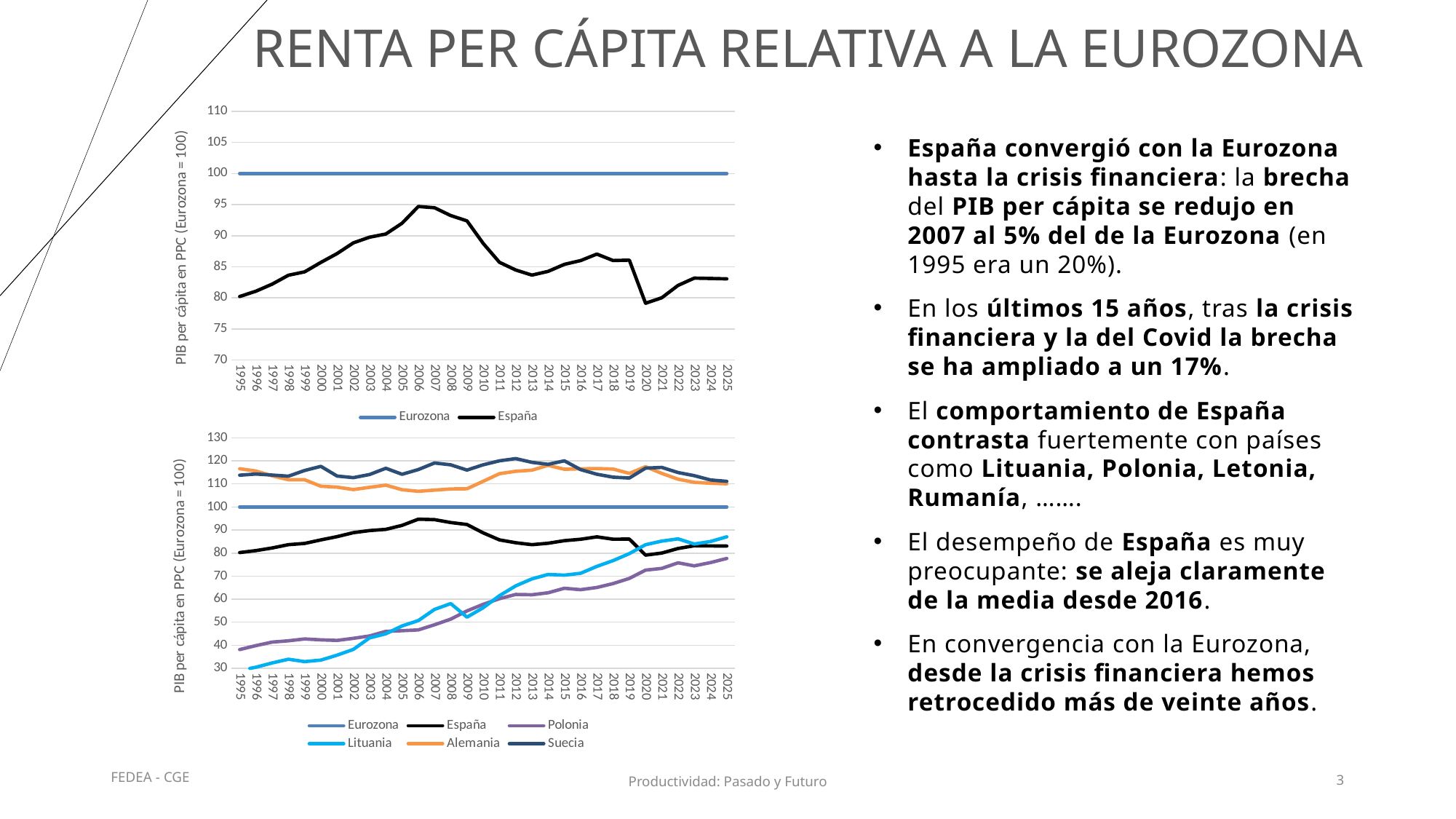
In the top chart, is the value for España in 2020 greater or less than 80? less In the bottom chart, which series has the lowest value in 1995? Lituania How many series does the legend of the bottom chart list? 6 In the top chart, is the value for España in 2013 greater or less than 85? less In the bottom chart, which is larger in 2025, Lituania or Polonia? Lituania In the top chart, is the value for España in 2007 greater or less than 90? greater What kind of chart is the top chart on the slide? line chart In the top chart, what is the value for Eurozona in 2010? 100 In the bottom chart, does the value for Lituania generally rise or fall from 1995 to 2025? rise How many series does the legend of the top chart list? 2